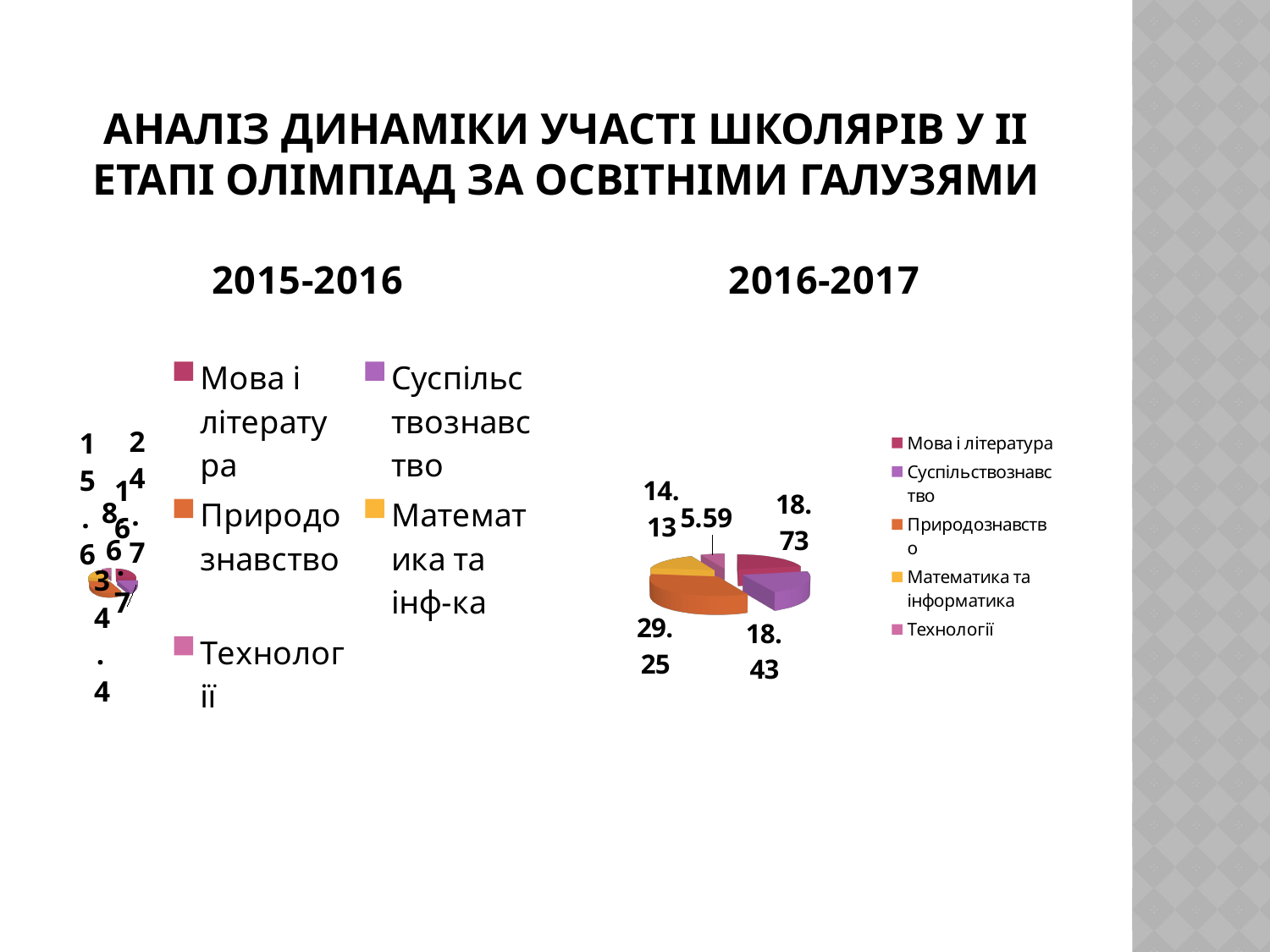
In the 2016-2017 chart, what is the value for Природознавство? 29.25 In the 2016-2017 chart, what colour is the Природознавство slice? Orange How many categories does the 2016-2017 chart show? 5 In the 2016-2017 chart, which is larger: Мова і література or Суспільствознавство? Мова і література In the 2016-2017 chart, what is the value for Технології? 5.59 In the 2016-2017 chart, which category has the smallest slice? Технології In the 2016-2017 chart, what is the value for Мова і література? 18.73 In the 2016-2017 chart, what is the difference between the values for Природознавство and Математика та інформатика? 15.12 In the 2016-2017 chart, what is the value for Математика та інформатика? 14.13 How many entries does the legend of the 2016-2017 chart list? 5 In the 2016-2017 chart, which category has the largest slice? Природознавство What kind of chart is the 2016-2017 chart? Pie chart